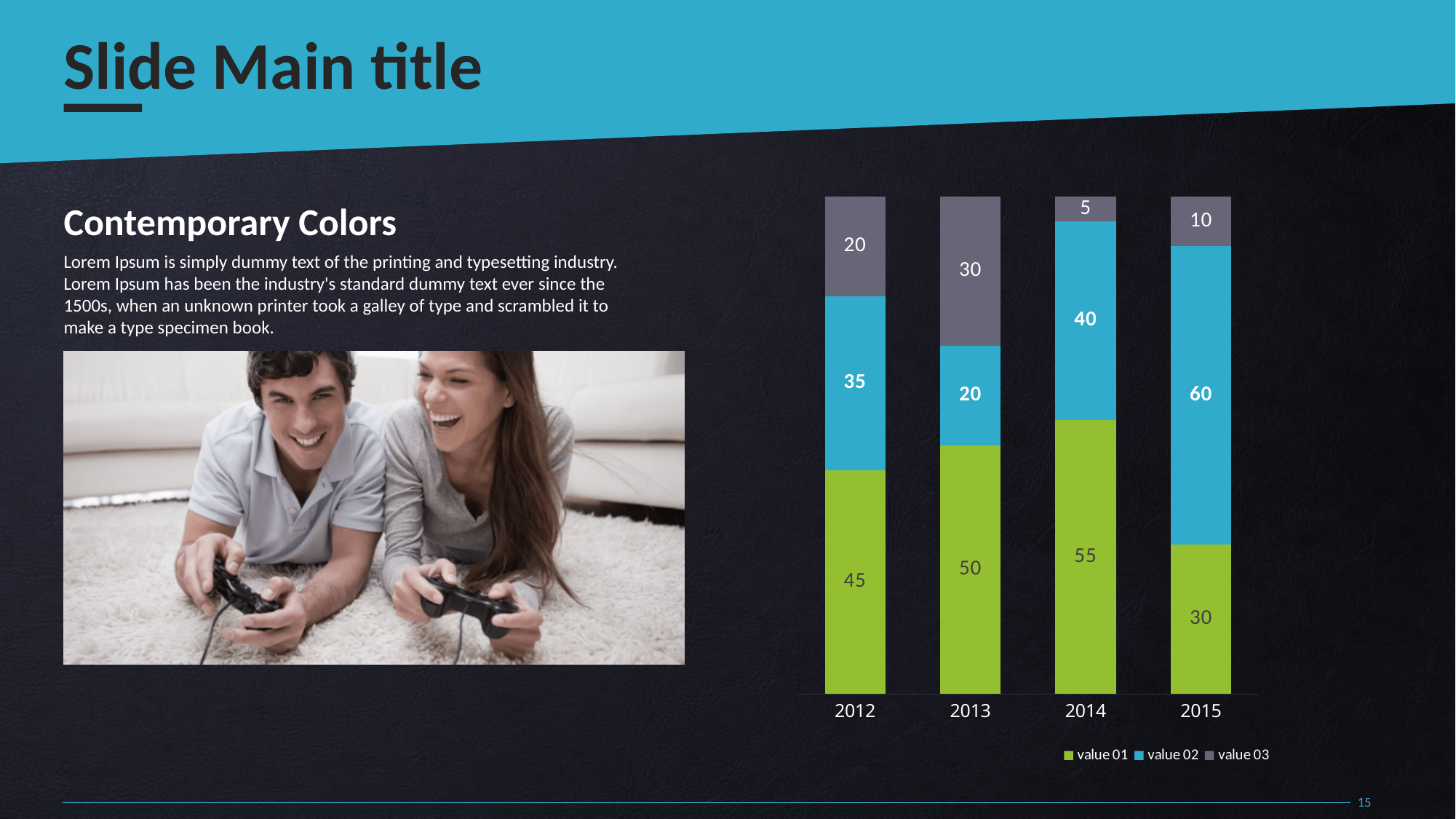
What is the value of value 01 for 2013? 50 Which year has the highest value for value 01? 2014 What kind of chart is shown on the slide? stacked bar chart What is the value of value 03 for 2014? 5 Which series is shown in green in the chart? value 01 How many series does the chart legend list? 3 How many years are shown on the x axis of the chart? 4 What is the difference between value 02 for 2015 and value 02 for 2013? 40 Which is larger: value 01 for 2012 or value 01 for 2015? value 01 for 2012 What is the total of the stacked bar for 2012? 100 Which year has the lowest value for value 03? 2014 What is the value of value 02 for 2015? 60